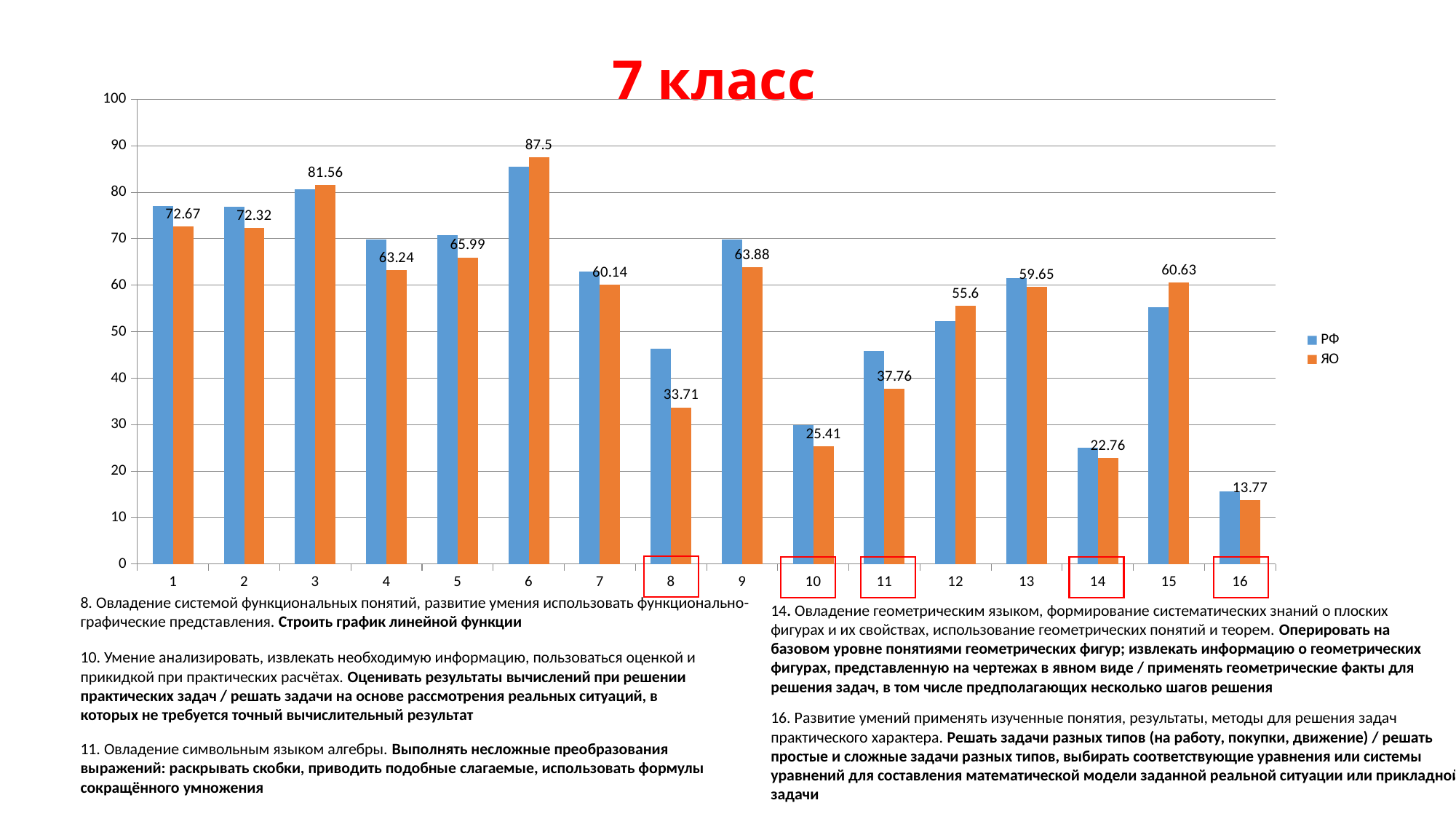
How many series does the legend list? 2 Which category has the highest ЯО value? 6 Is the РФ value for category 8 greater or less than 40? greater What is the ЯО value for category 8? 33.71 What is the ЯО value for category 16? 13.77 For category 8, which series has the larger value, РФ or ЯО? РФ What is the title of the chart? 7 класс What is the ЯО value for category 6? 87.5 What is the difference between the ЯО values for category 6 and category 16? 73.73 For category 15, which series has the larger value, РФ or ЯО? ЯО How many categories are shown on the x axis? 16 Which category has the lowest ЯО value? 16